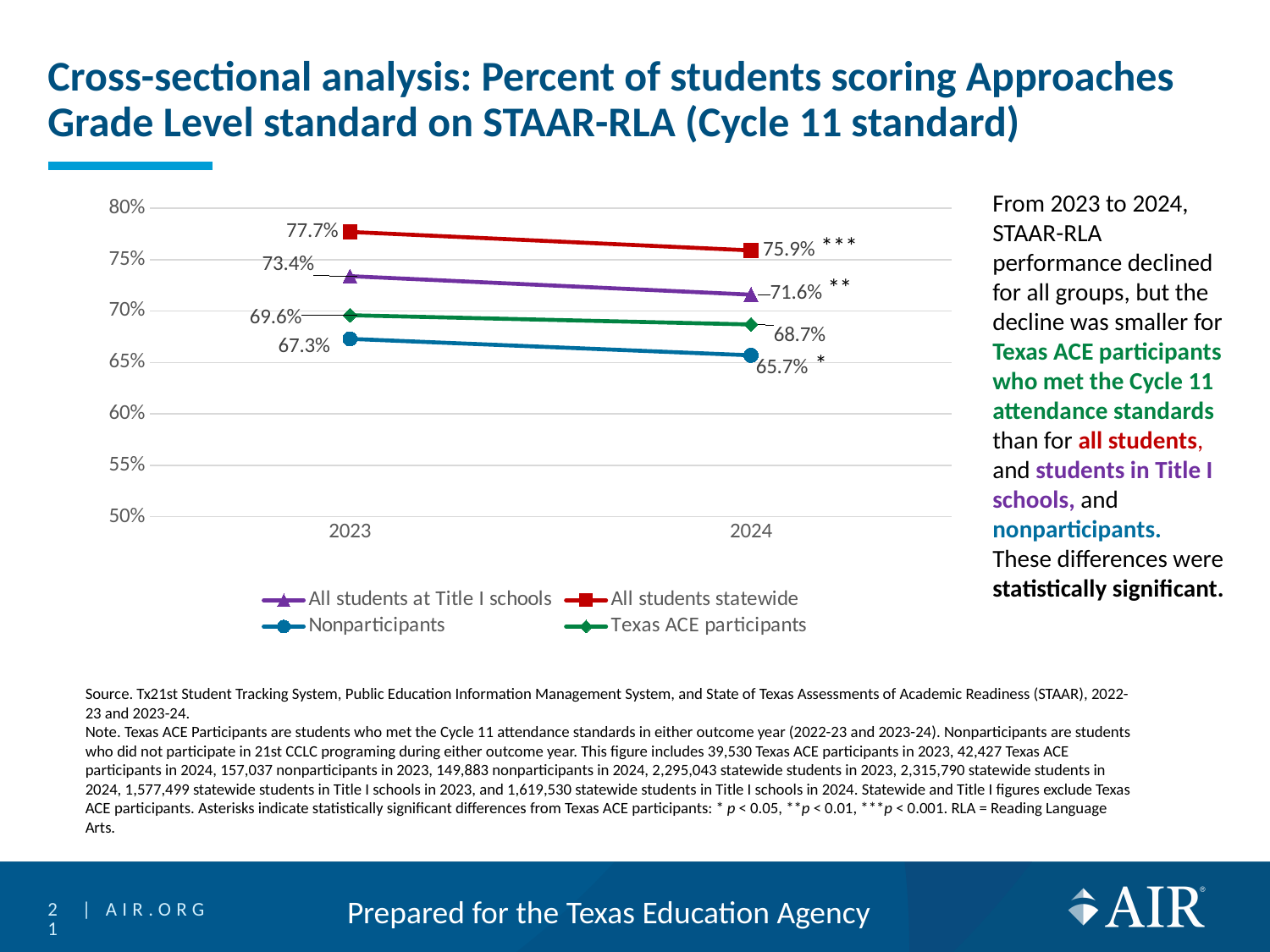
How many years are shown on the x axis? 2 Which group had the highest value in 2024? All students statewide How many series does the legend list? 4 What percent of all students statewide scored Approaches Grade Level in 2023? 77.7% What is the difference between All students statewide and Nonparticipants in 2024? 10.2 percentage points What was the value for All students at Title I schools in 2024? 71.6% Did the value for All students at Title I schools rise or fall from 2023 to 2024? Fall By how many percentage points did the value for Texas ACE participants change from 2023 to 2024? 0.9 percentage points Which group had the lowest value in 2023? Nonparticipants What was the value for Texas ACE participants in 2024? 68.7% What type of chart is shown on the slide? Line chart What was the value for Nonparticipants in 2023? 67.3%